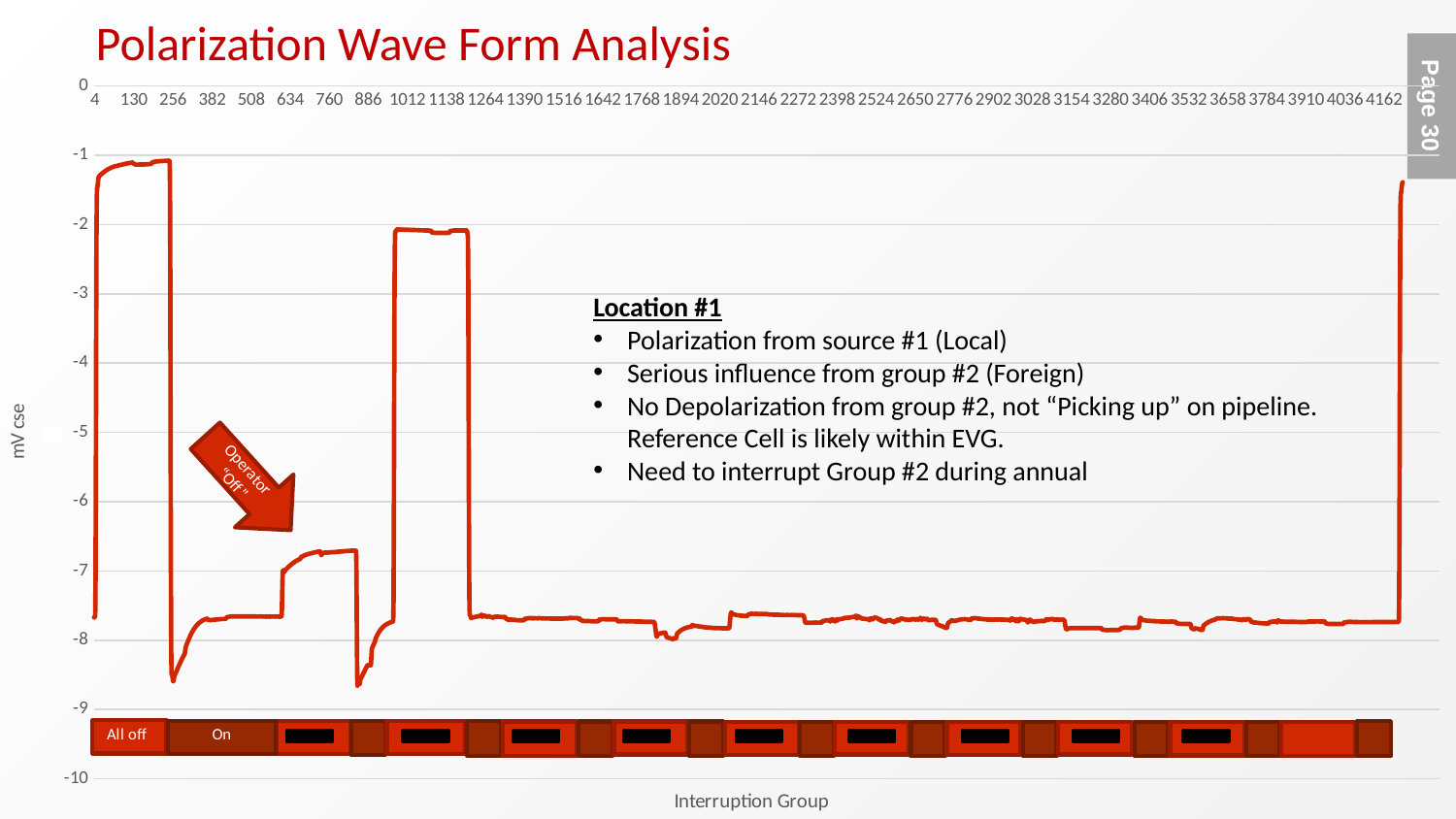
What kind of chart is shown on the slide? line chart What is the first tick label on the horizontal axis? 4 Is the value of the line at x = 1012 greater or less than -3? greater What is the last tick label on the horizontal axis? 4162 What is the title of the chart on the slide? Polarization Wave Form Analysis What is the highest tick label shown on the vertical axis? 0 Is the value of the line at x = 130 greater or less than -2? greater How many series are plotted on the chart? 1 What is the lowest tick label shown on the vertical axis? -10 Is the value of the line at x = 2020 greater or less than -7? less How many tick labels are shown on the horizontal axis? 34 What is the label of the vertical axis of the chart? mV cse